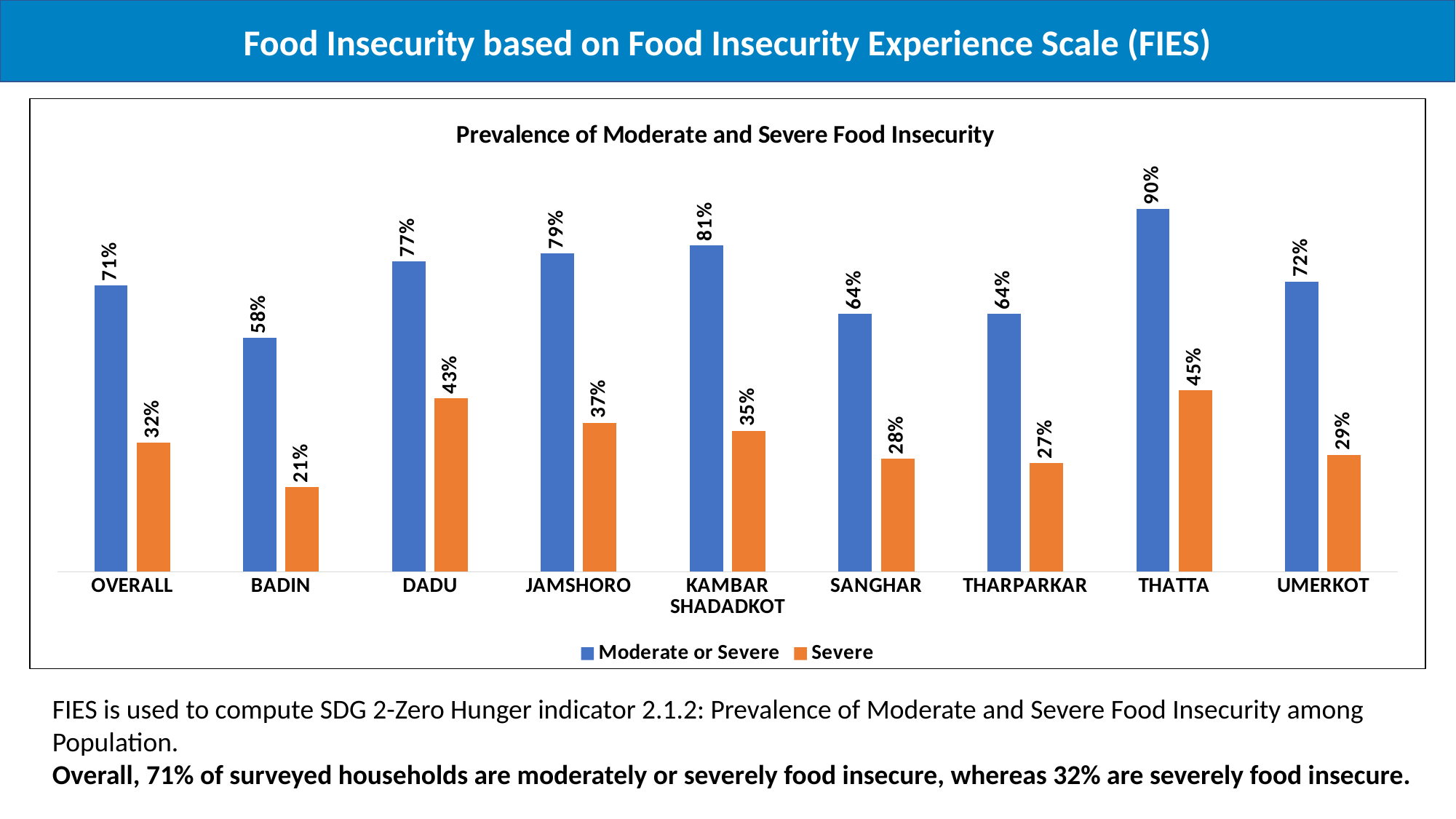
What colour are the Severe bars? Orange What kind of chart is shown? Bar chart What is the title of the chart? Prevalence of Moderate and Severe Food Insecurity What is the Moderate or Severe value for THATTA? 90% What is the Moderate or Severe value for KAMBAR SHADADKOT? 81% How many series does the legend list? 2 Which is larger, the Severe value for JAMSHORO or the Severe value for UMERKOT? JAMSHORO Which category has the lowest Moderate or Severe value? BADIN Which category has the highest Severe value? THATTA What is the difference between the Moderate or Severe and Severe values for OVERALL? 39% What is the Severe value for DADU? 43% How many categories are shown on the x axis? 9